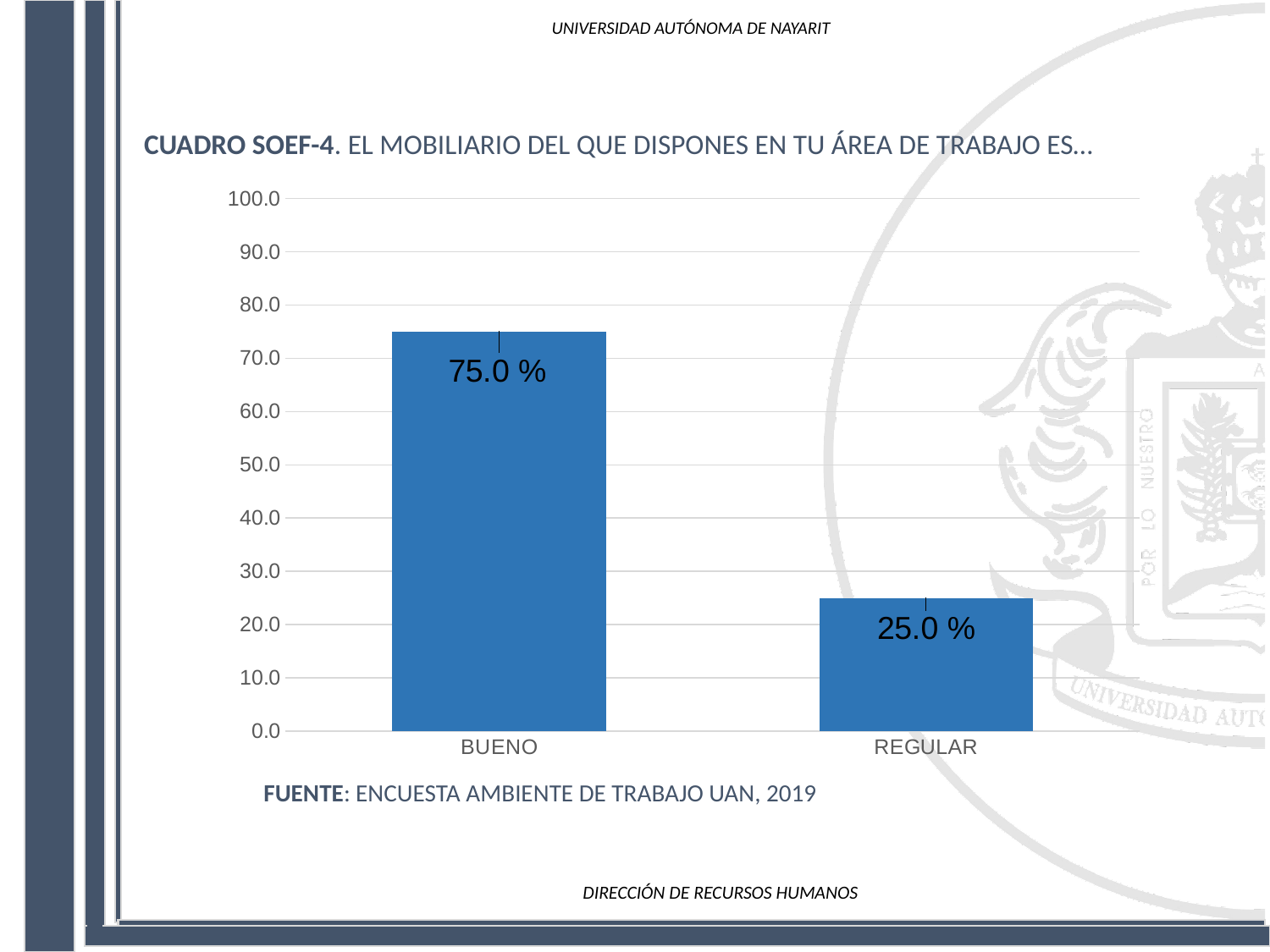
What is the value for REGULAR? 25.0 % What is the maximum value shown on the y axis? 100.0 What is the difference between the values for BUENO and REGULAR? 50.0 % What is the value for BUENO? 75.0 % Is the value for REGULAR greater or less than 30.0? less What source is cited below the chart? ENCUESTA AMBIENTE DE TRABAJO UAN, 2019 How many categories are shown on the x axis? 2 Is the value for BUENO greater or less than 70.0? greater What kind of chart is shown on the slide? bar chart Which is larger, the value for BUENO or the value for REGULAR? BUENO Which category has the lowest value? REGULAR Which category has the highest value? BUENO